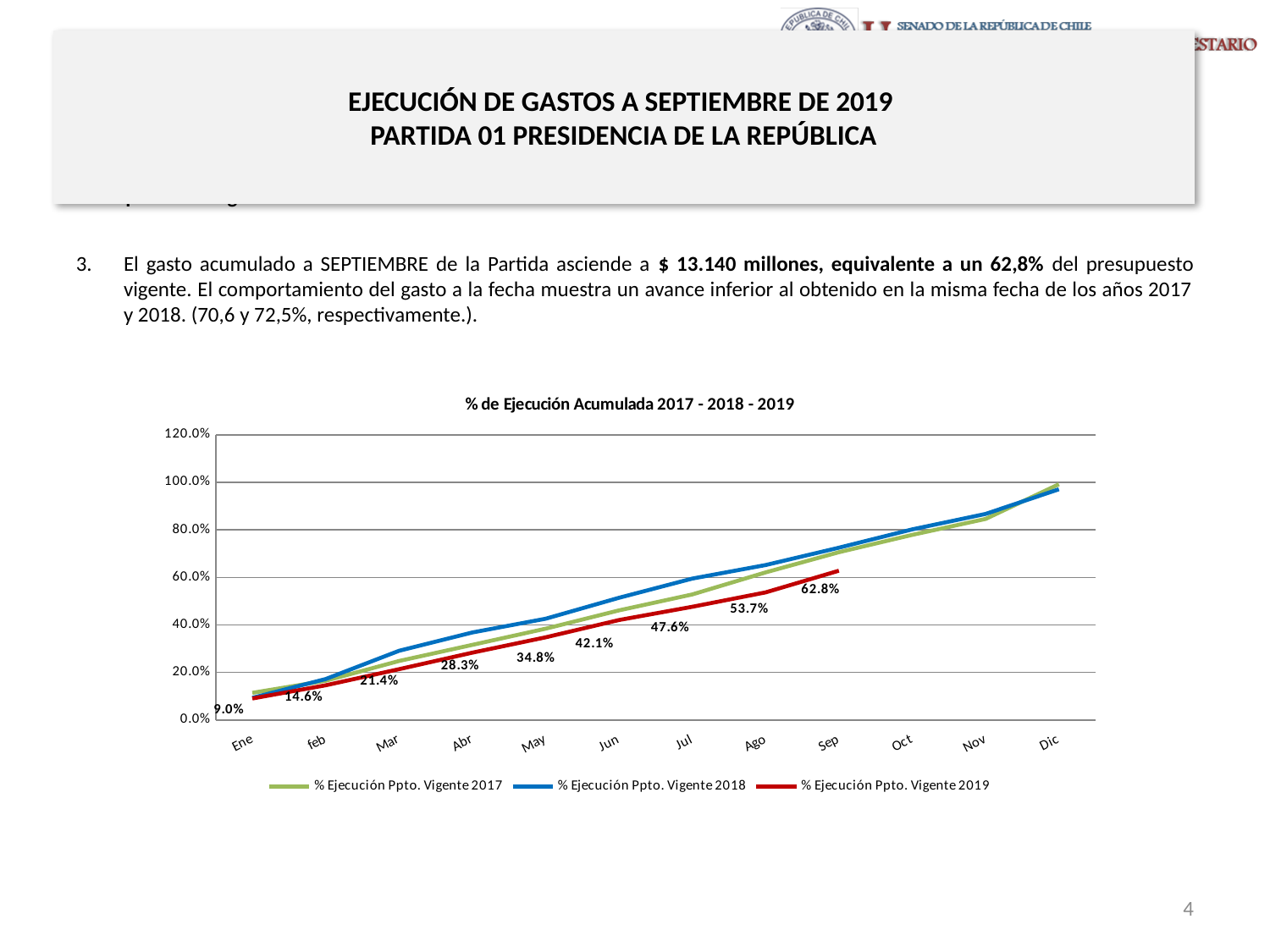
What type of chart is shown on the slide? line chart In which month does the % Ejecución Ppto. Vigente 2019 series reach its highest value? Sep What is the value for % Ejecución Ppto. Vigente 2019 in Jun? 42.1% In Sep, which series has the larger value: % Ejecución Ppto. Vigente 2018 or % Ejecución Ppto. Vigente 2019? % Ejecución Ppto. Vigente 2018 What is the value for % Ejecución Ppto. Vigente 2019 in Sep? 62.8% What is the title of the chart? % de Ejecución Acumulada 2017 - 2018 - 2019 How many series does the legend list? 3 Is the value for % Ejecución Ppto. Vigente 2018 in Dic greater or less than 80.0%? greater What is the difference between the 2019 values for Sep and Ago? 9.1 percentage points Do the values of the % Ejecución Ppto. Vigente 2019 series rise or fall from Ene to Sep? rise What is the value for % Ejecución Ppto. Vigente 2019 in Ene? 9.0% How many months are shown on the x axis? 12